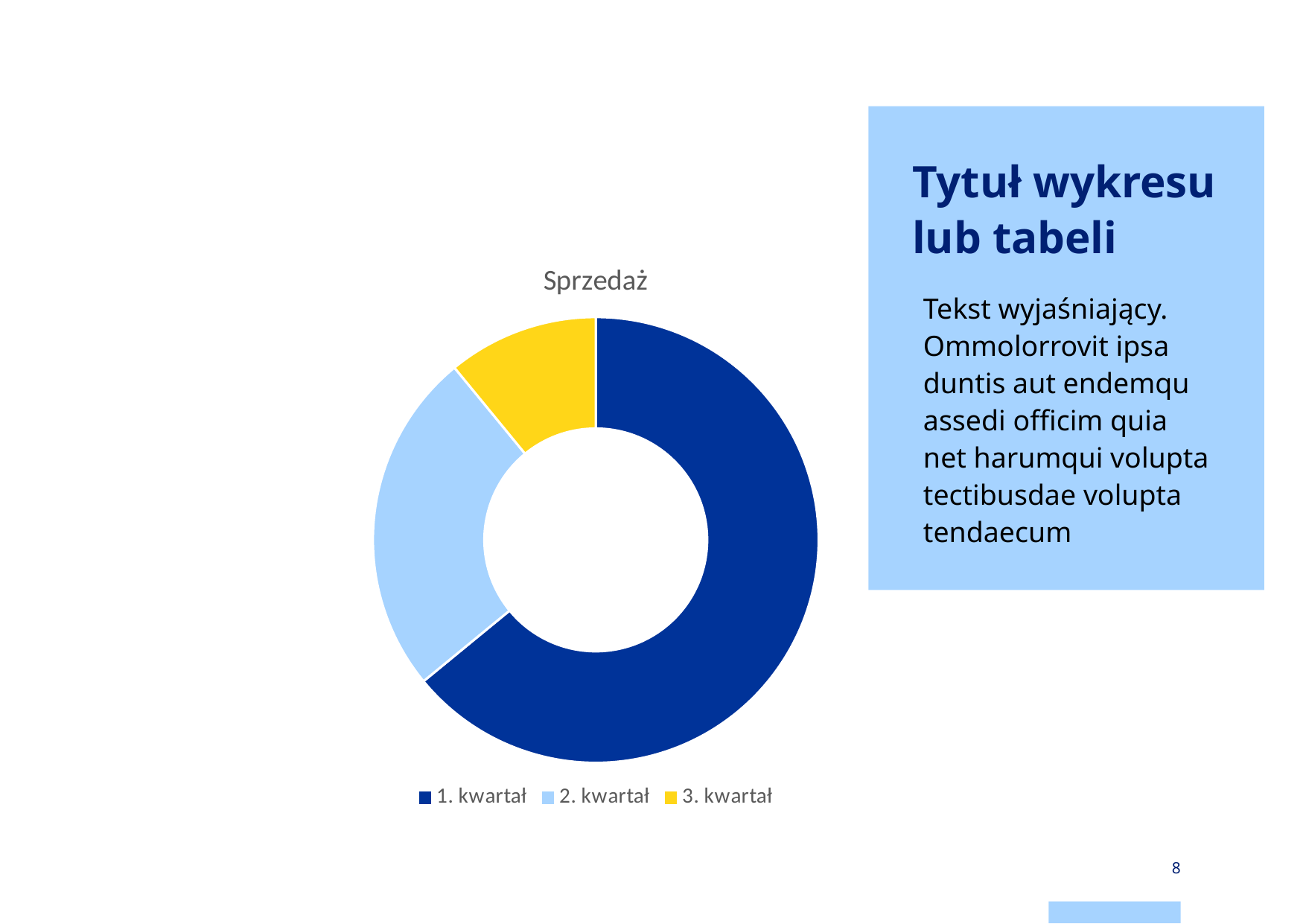
What kind of chart is shown on the slide? doughnut chart Which is smaller, the slice for 1. kwartał or the slice for 3. kwartał? 3. kwartał How many entries does the chart legend list? 3 How many slices does the chart have? 3 What is the title of the chart? Sprzedaż Which is larger, the slice for 2. kwartał or the slice for 3. kwartał? 2. kwartał Does the slice for 1. kwartał take up more or less than half of the chart? more Which category has the smallest slice in the chart? 3. kwartał Which category has the largest slice in the chart? 1. kwartał Which is larger, the slice for 1. kwartał or the slice for 2. kwartał? 1. kwartał What colour is the slice for 3. kwartał? yellow